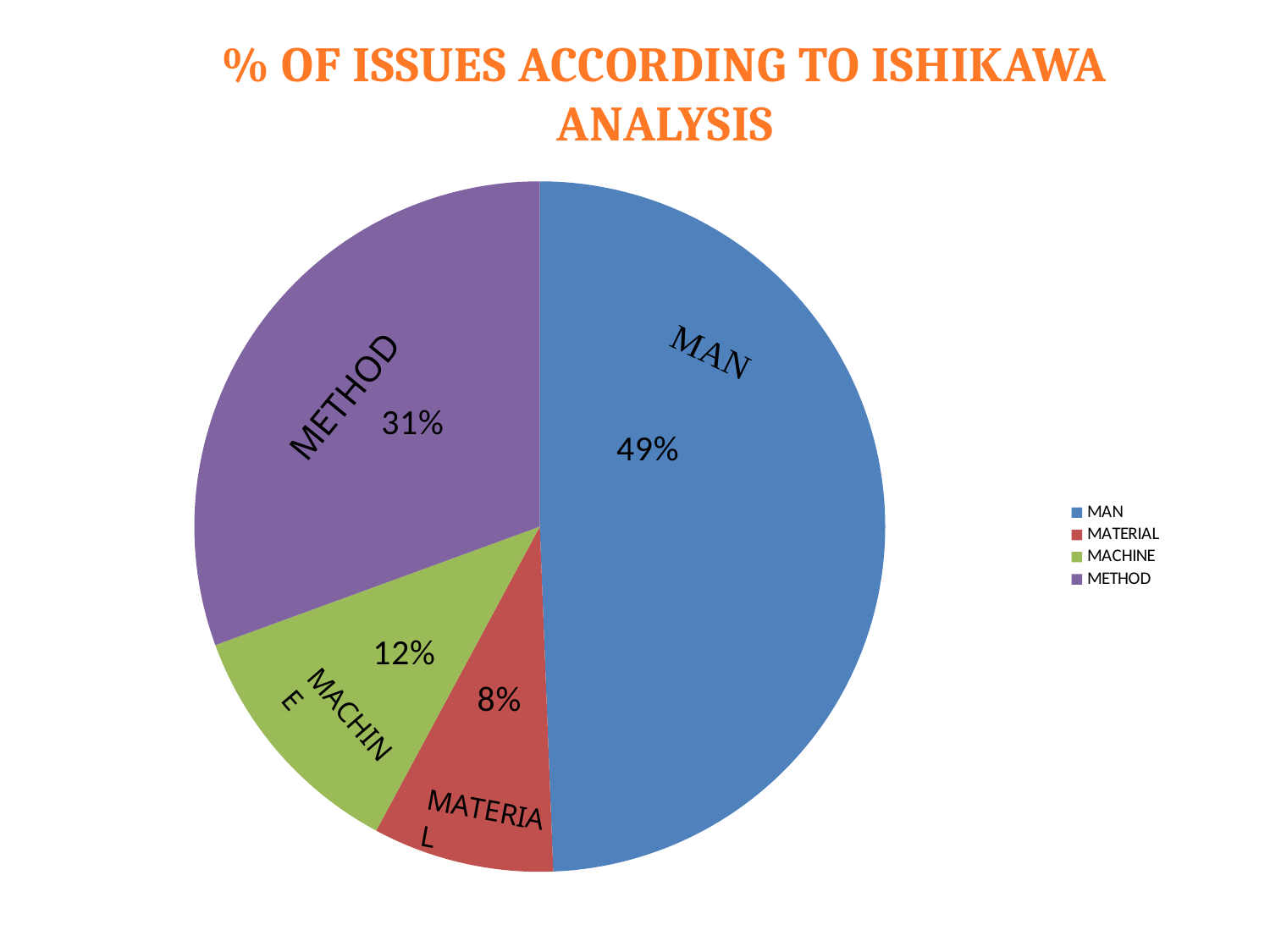
What type of chart is shown on the slide? pie chart Which category accounts for the largest share of issues? MAN What percentage of issues is attributed to METHOD? 31% How many categories are shown in the pie chart? 4 What percentage of issues is attributed to MAN? 49% What is the title of the chart? % OF ISSUES ACCORDING TO ISHIKAWA ANALYSIS Which category accounts for the smallest share of issues? MATERIAL Which colour represents METHOD in the chart? purple What percentage of issues is attributed to MACHINE? 12% What is the difference in percentage points between MAN and METHOD? 18 What percentage of issues is attributed to MATERIAL? 8% Which has a larger share of issues, MACHINE or MATERIAL? MACHINE